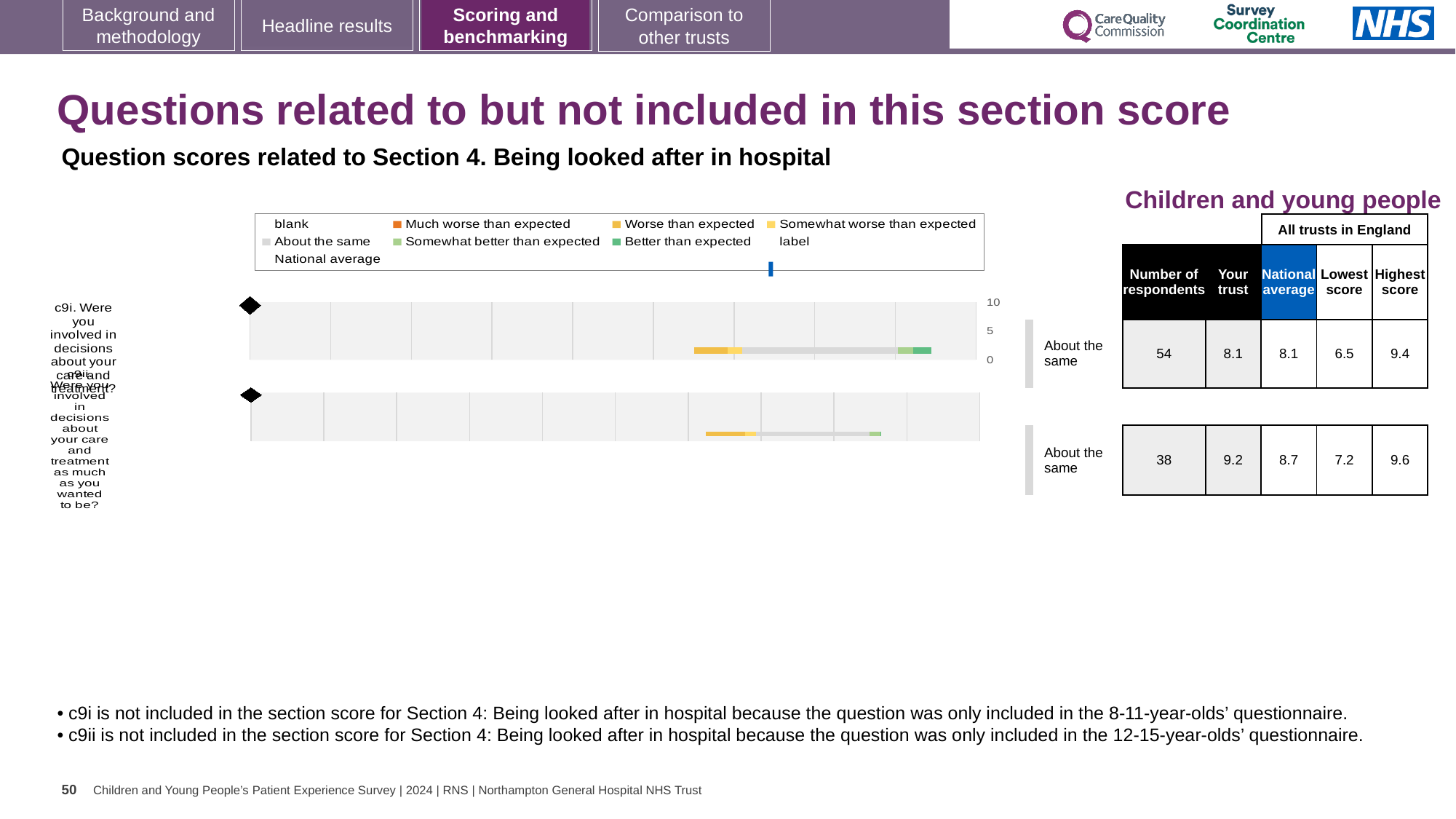
How many respondents answered question c9i? 54 What is the highest value shown on the chart's score axis? 10 What is the highest score among all trusts in England for question c9ii? 9.6 What is the difference between the 'Your trust' score and the national average for question c9ii? 0.5 What is the 'Your trust' score for question c9ii? 9.2 What is the lowest score among all trusts in England for question c9i? 6.5 What kind of chart is used to show the question scores for c9i and c9ii? bar chart How many questions (bars) are plotted in the chart? 2 What is the national average score for question c9ii? 8.7 Which question has the higher 'Your trust' score, c9i or c9ii? c9ii What is the 'Your trust' score for question c9i? 8.1 What benchmark category is shown next to the bar for question c9i? About the same